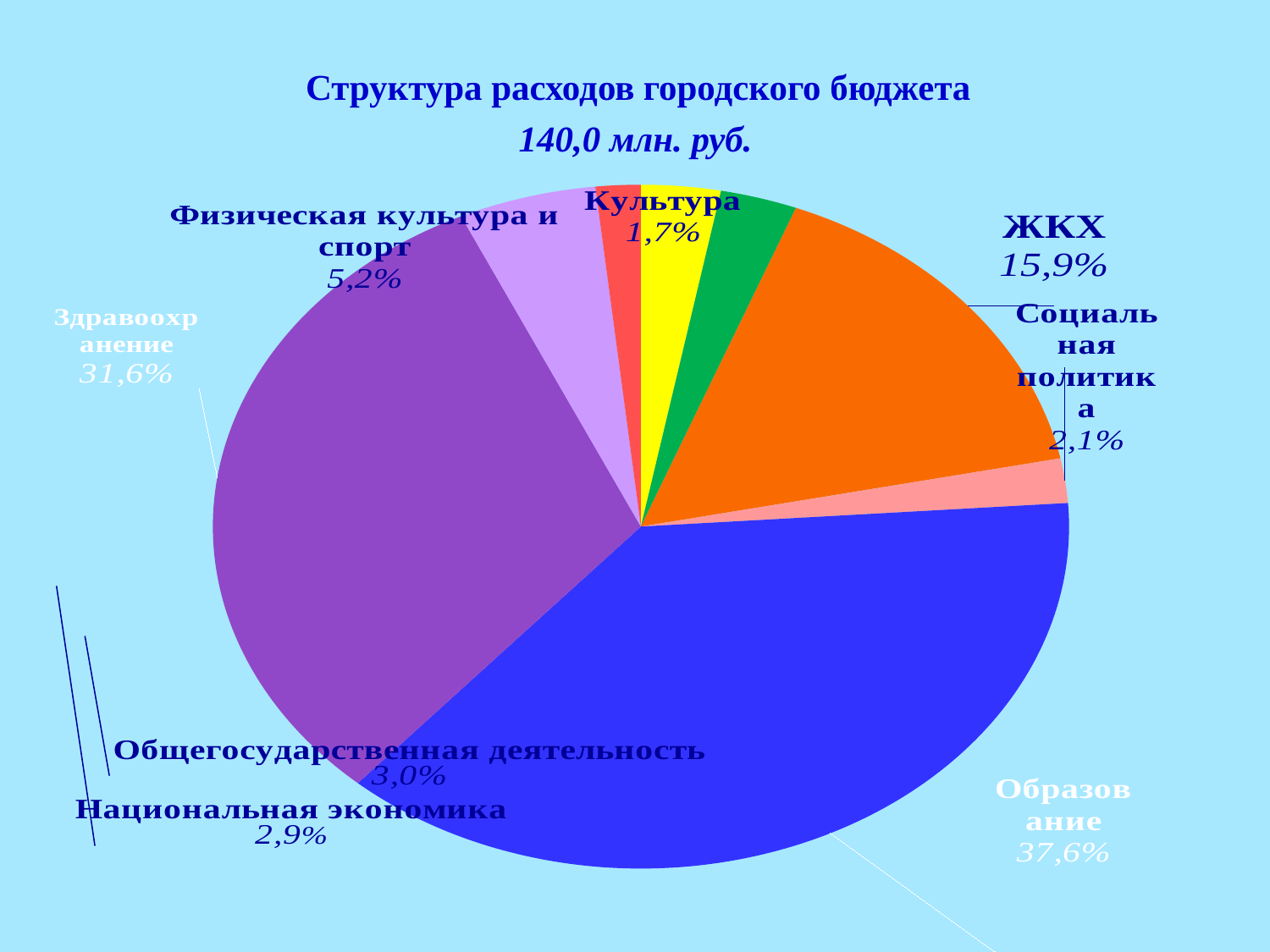
What is the difference in percentage points between Образование and Здравоохранение? 6,0% How many categories are shown in the pie chart? 8 What total budget amount is stated in the chart title? 140,0 млн. руб. What is the share of Физическая культура и спорт? 5,2% What is the share of Культура in the pie chart? 1,7% What type of chart is shown on the slide? Pie chart Which has a larger share: Общегосударственная деятельность or Национальная экономика? Общегосударственная деятельность Which category has the largest share of the city budget expenditures? Образование What is the share of Образование in the pie chart? 37,6% What is the share of Здравоохранение in the pie chart? 31,6% Which category has the smallest share in the pie chart? Культура What percentage does ЖКХ account for in the pie chart? 15,9%